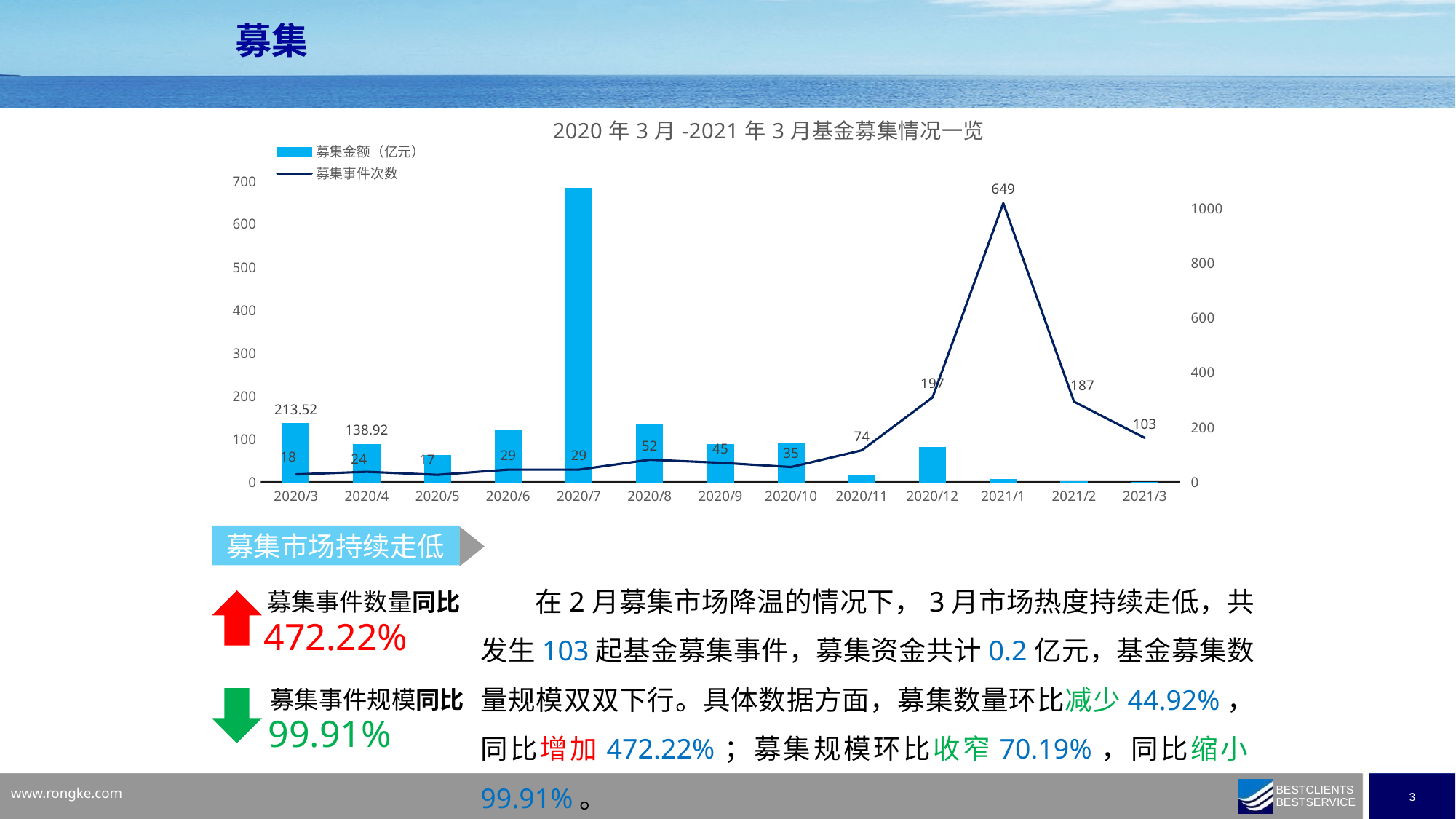
Which month has more 募集事件次数, 2020/8 or 2020/9? 2020/8 What kind of chart is shown on the slide? A combined bar and line chart How many series does the chart legend list? 2 What is the 募集金额（亿元） value labelled for 2020/3? 213.52 Which month has the lowest 募集事件次数? 2020/5 Which month has the highest 募集事件次数? 2021/1 What is the 募集金额（亿元） value labelled for 2020/4? 138.92 What is the difference in 募集事件次数 between 2021/1 and 2021/2? 462 What is the value of 募集事件次数 for 2021/3? 103 Which month has the tallest 募集金额（亿元） bar? 2020/7 How many months are shown along the x axis of the chart? 13 What is the value of 募集事件次数 for 2021/1? 649